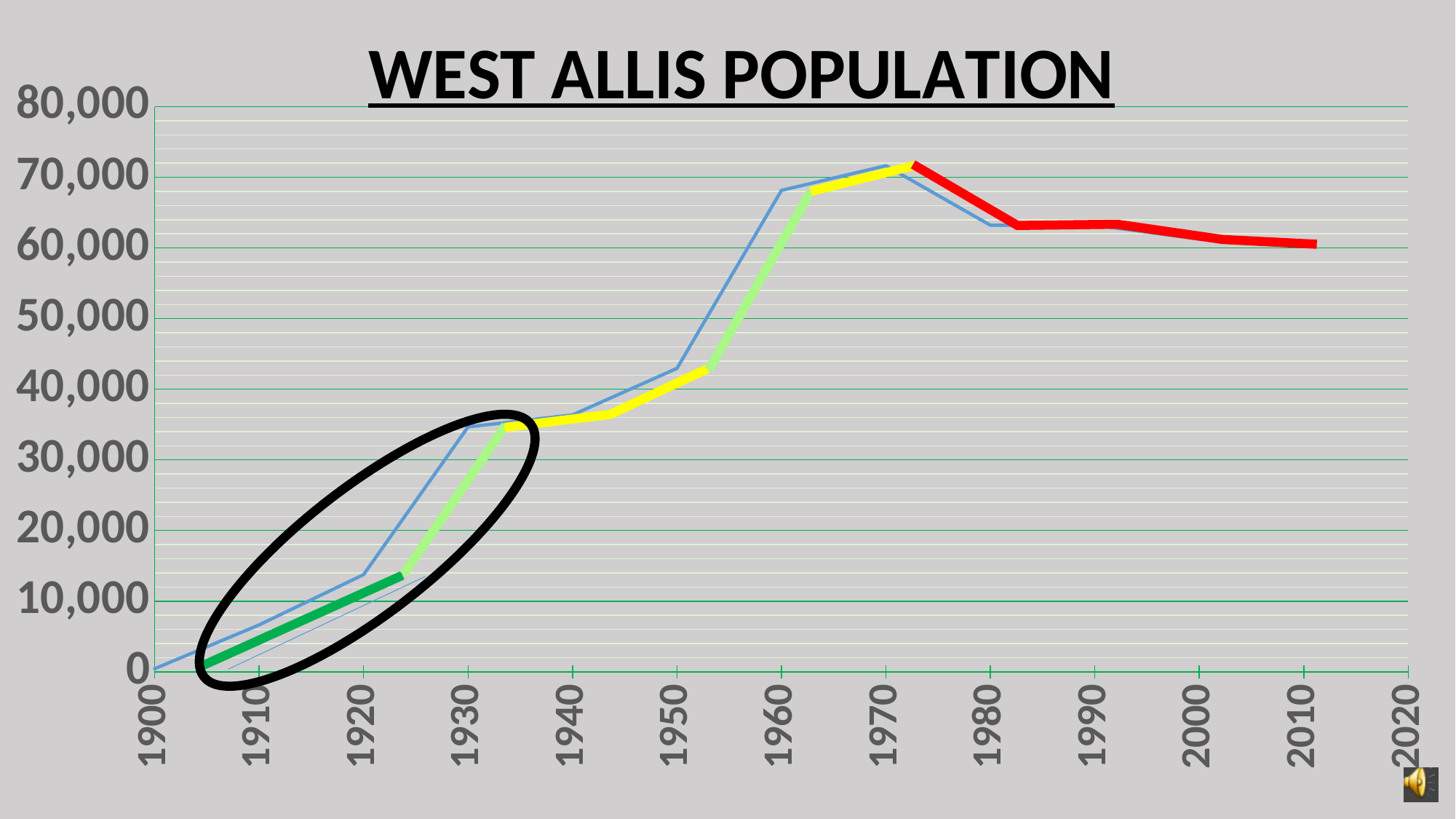
Is the population value for 1950 greater or less than 40,000? greater What is the title of the chart? WEST ALLIS POPULATION Does the population rise or fall between 1970 and 2010? fall In which year shown on the x axis does the population reach its highest value? 1970 Is the population value for 1920 greater or less than 20,000? less Which year has the larger population, 1950 or 1960? 1960 In which year shown on the x axis is the population lowest? 1900 How many year labels are shown along the x axis? 13 What kind of chart is shown on the slide? line chart Which year has the larger population, 1970 or 2010? 1970 Is the population value for 1960 greater or less than 60,000? greater